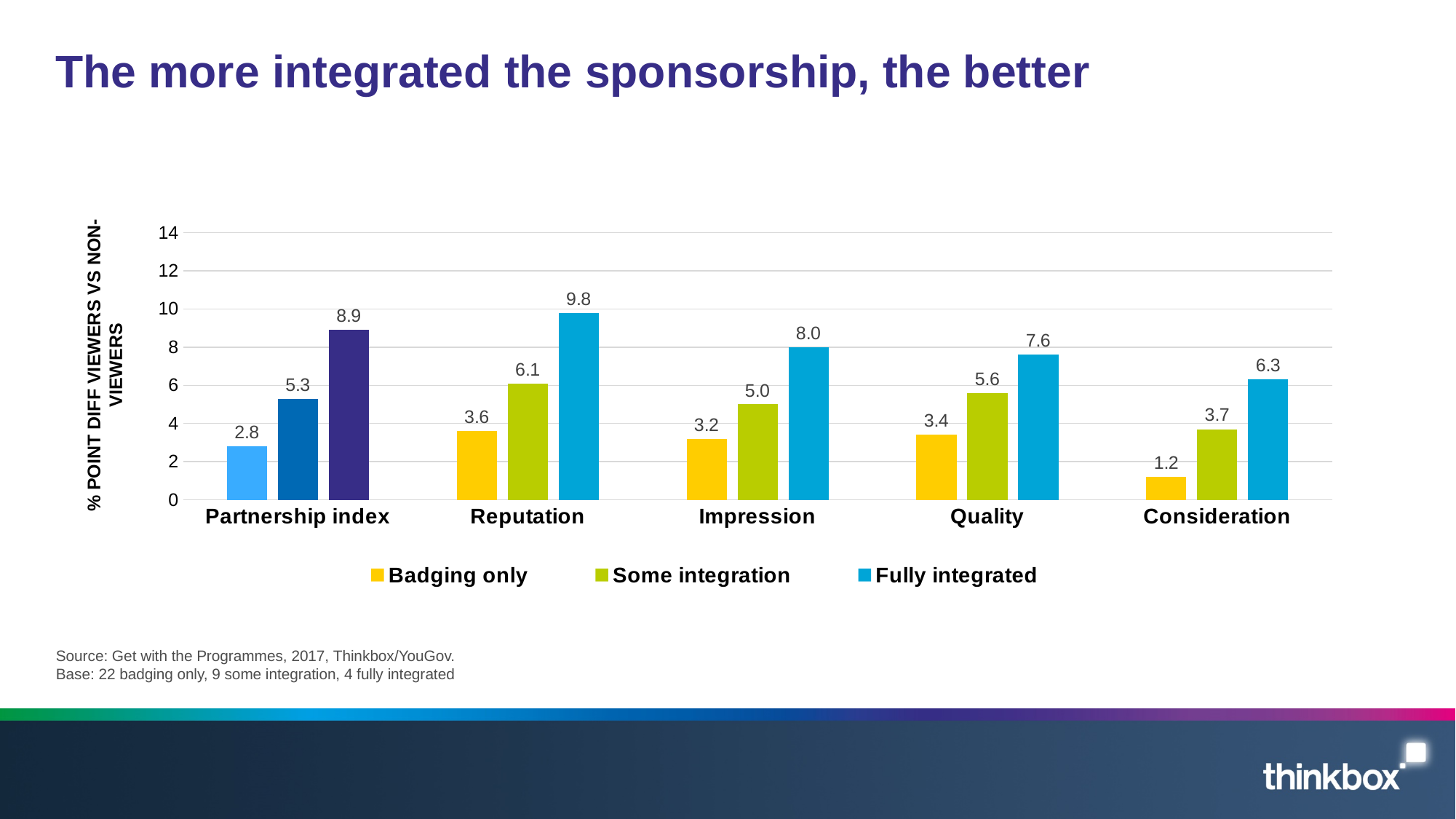
Which is larger in the Partnership index category: the Some integration value or the Badging only value? Some integration Which category has the highest Fully integrated value? Reputation What is the value for Badging only in the Consideration category? 1.2 Which category has the lowest Badging only value? Consideration Is the Fully integrated value for Quality greater or less than 6? greater What is the title of the slide? The more integrated the sponsorship, the better What is the difference between the Fully integrated and Badging only values for Impression? 4.8 How many categories are shown on the x axis? 5 What is the value for Fully integrated in the Reputation category? 9.8 What kind of chart is shown on the slide? Bar chart What is the value for Some integration in the Quality category? 5.6 How many series does the legend list? 3